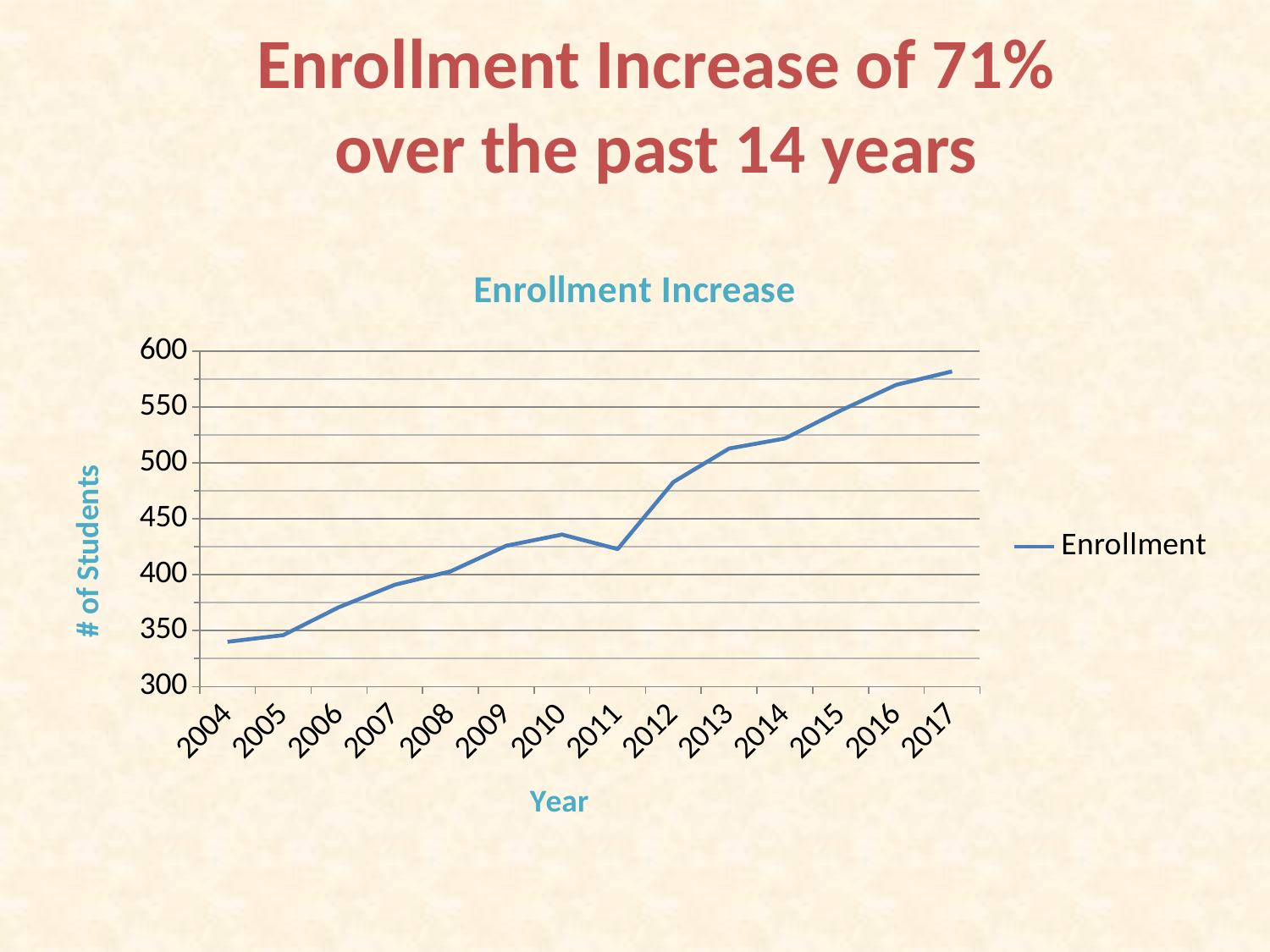
What is the title of the chart? Enrollment Increase Is the enrollment value for 2011 greater or less than 450? less How many years are plotted on the x axis? 14 Which year has the highest enrollment? 2017 What is the label on the vertical axis of the chart? # of Students How many series does the legend list? 1 Is the enrollment value for 2004 greater or less than 350? less Overall, does enrollment rise or fall from 2004 to 2017? Rise Which year has the lowest enrollment? 2004 Is the enrollment value for 2017 greater or less than 550? greater What kind of chart is shown on the slide? Line chart Which year has the larger enrollment, 2010 or 2011? 2010